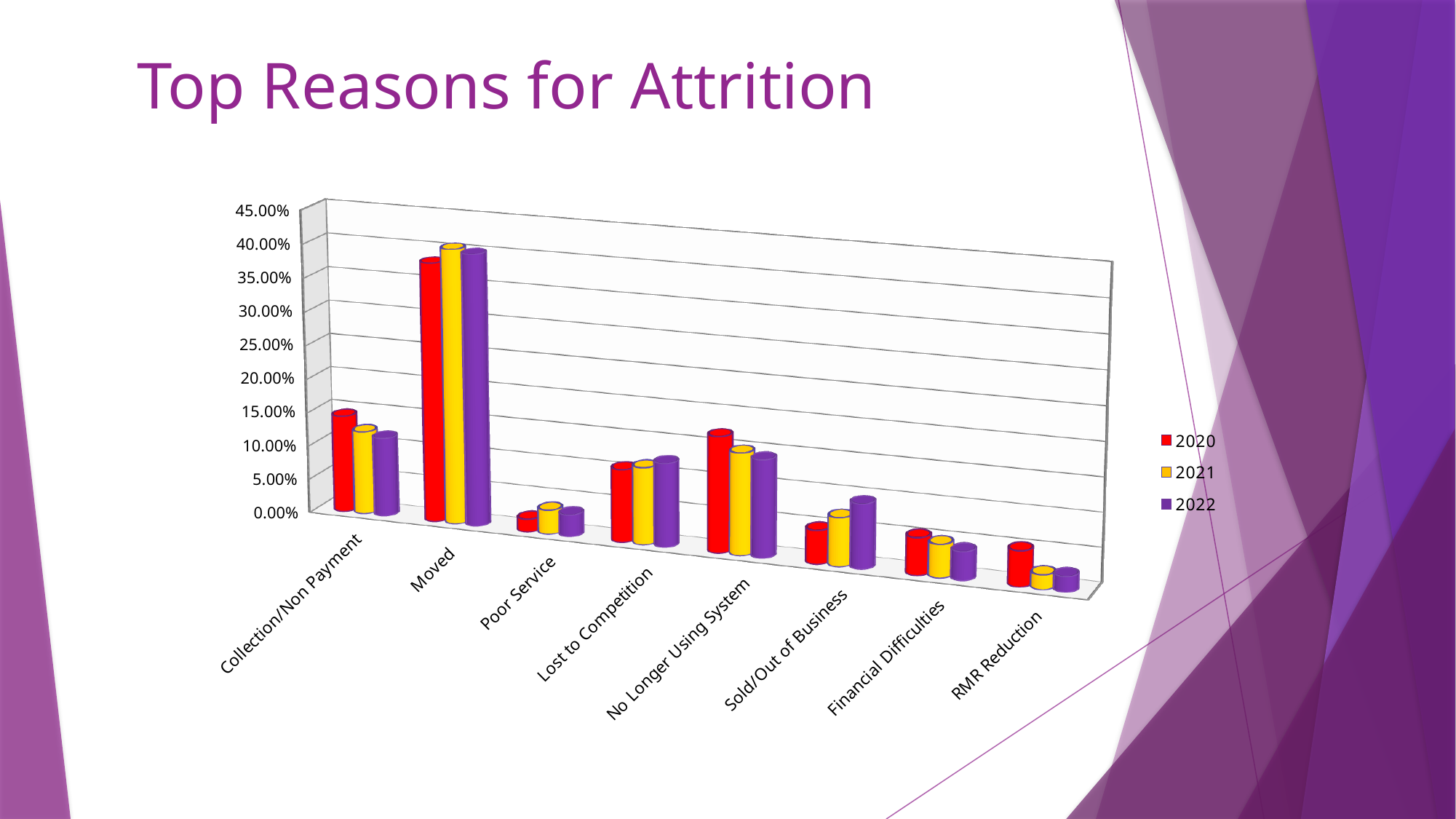
For 2020, which is larger: the value for Moved or the value for Collection/Non Payment? Moved For 2020, which is larger: the value for Poor Service or the value for Lost to Competition? Lost to Competition Which category has the highest value for 2021? Moved How many reason categories are shown on the x axis of the chart? 8 Is the 2020 value for Collection/Non Payment greater or less than 20.00%? less Is the 2020 value for Poor Service greater or less than 5.00%? less Is the 2020 value for Moved greater or less than 30.00%? greater What kind of chart is shown on the slide? bar chart What is the title of the slide containing the chart? Top Reasons for Attrition How many series does the chart's legend list? 3 Which category has the highest value for 2020? Moved